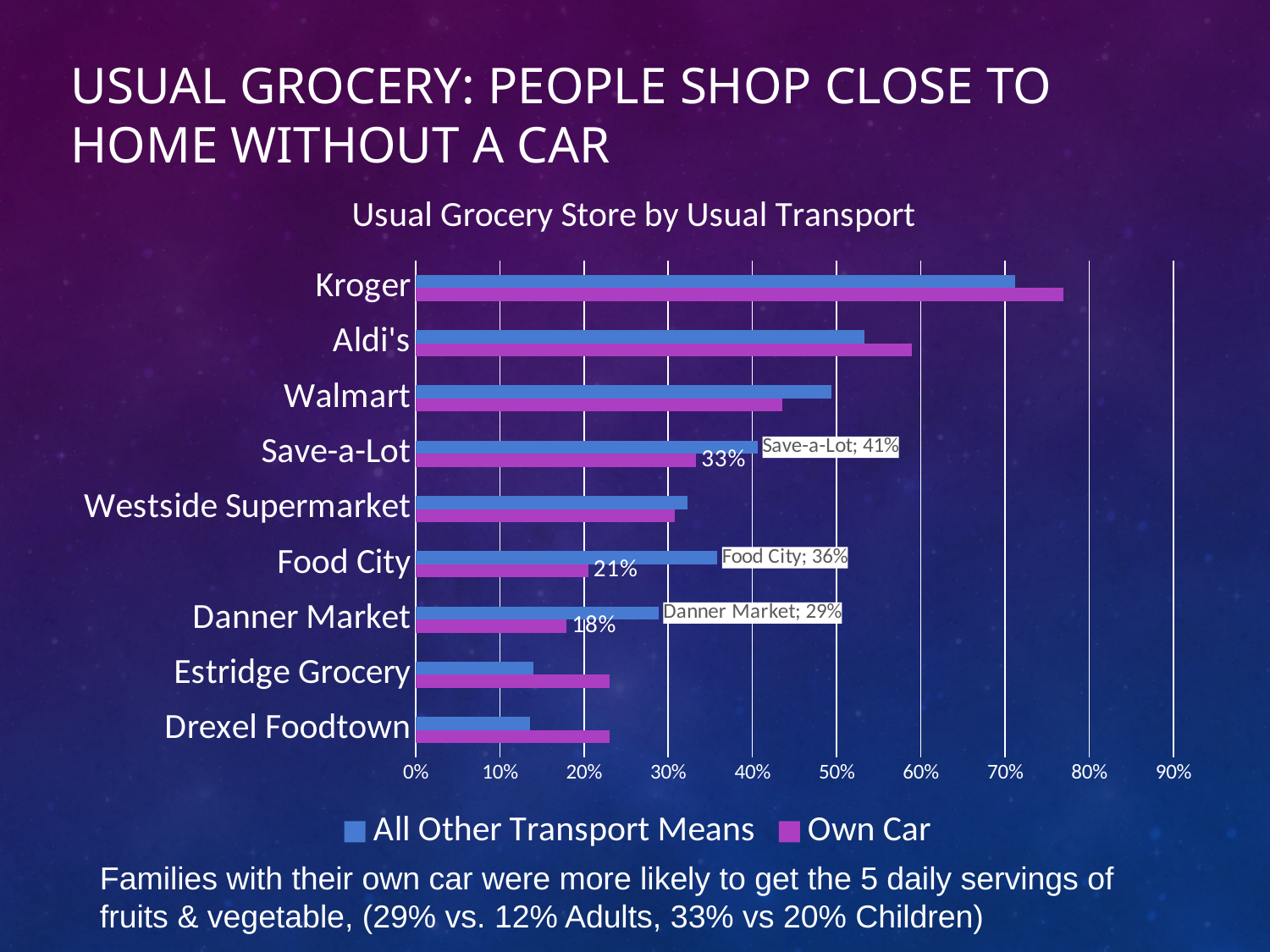
What kind of chart is shown on the slide? Bar chart What is the difference between the All Other Transport Means value and the Own Car value for Save-a-Lot? 8 percentage points What is the value for Danner Market in the All Other Transport Means series? 29% How many grocery stores are listed on the chart? 9 How many series does the legend list? 2 Which store has the highest value in the Own Car series? Kroger Is the Own Car value for Kroger greater or less than 70%? greater What is the value for Food City in the Own Car series? 21% For Walmart, which series has the larger value: All Other Transport Means or Own Car? All Other Transport Means What is the title of the chart? Usual Grocery Store by Usual Transport What is the value for Save-a-Lot in the All Other Transport Means series? 41% What is the difference between the All Other Transport Means value and the Own Car value for Food City? 15 percentage points